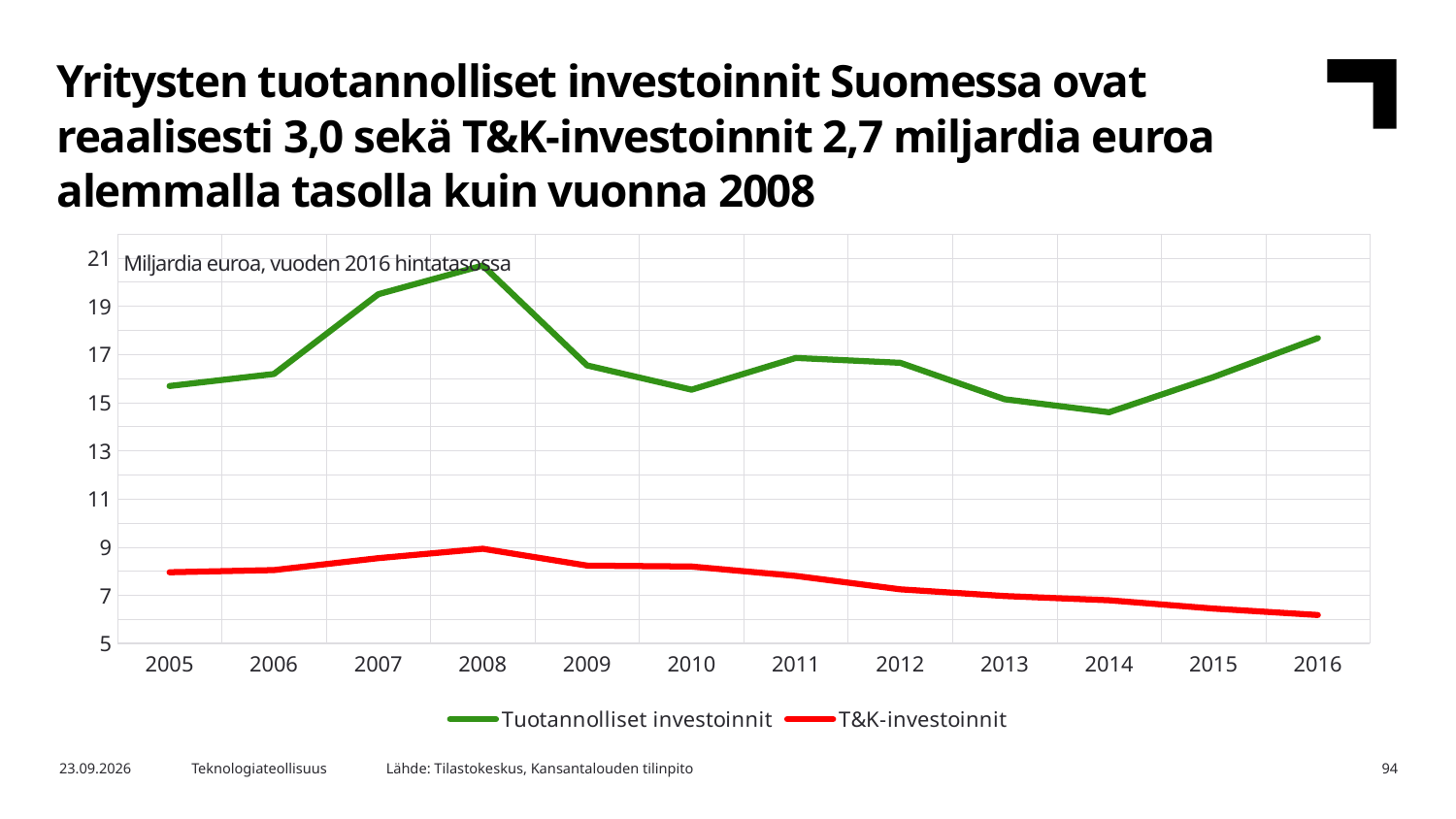
In which year is Tuotannolliset investoinnit lowest? 2014 In which year is T&K-investoinnit lowest? 2016 Does T&K-investoinnit rise or fall from 2008 to 2016? fall Is the value for Tuotannolliset investoinnit in 2008 greater or less than 19? greater In which year is T&K-investoinnit highest? 2008 What unit label is shown inside the chart area? Miljardia euroa, vuoden 2016 hintatasossa Which is larger: Tuotannolliset investoinnit in 2008 or in 2010? 2008 In which year is Tuotannolliset investoinnit highest? 2008 What kind of chart is shown on the slide? line chart Is the value for T&K-investoinnit in 2016 greater or less than 7? less How many years are shown on the x axis? 12 How many series does the legend list? 2